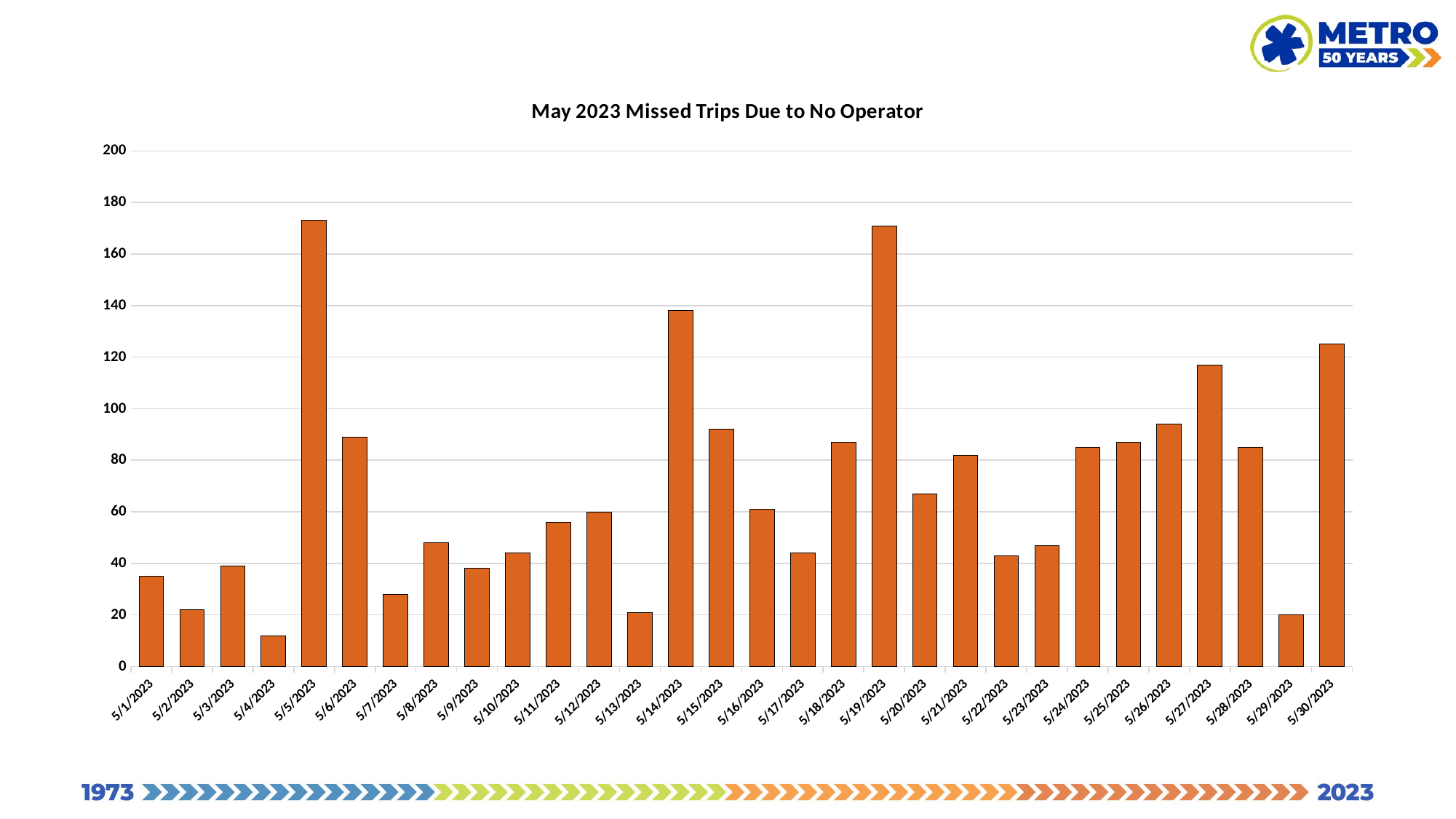
Which has more missed trips, 5/14/2023 or 5/15/2023? 5/14/2023 From 5/22/2023 to 5/27/2023, do the values rise or fall? rise What kind of chart is shown on the slide? bar chart Is the value for 5/14/2023 greater or less than 120? greater How many dates (bars) are plotted on the chart? 30 Is the value for 5/27/2023 greater or less than 100? greater Is the value for 5/6/2023 greater or less than 100? less What is the title of the chart? May 2023 Missed Trips Due to No Operator Which has more missed trips, 5/27/2023 or 5/28/2023? 5/27/2023 Which date has the lowest number of missed trips? 5/4/2023